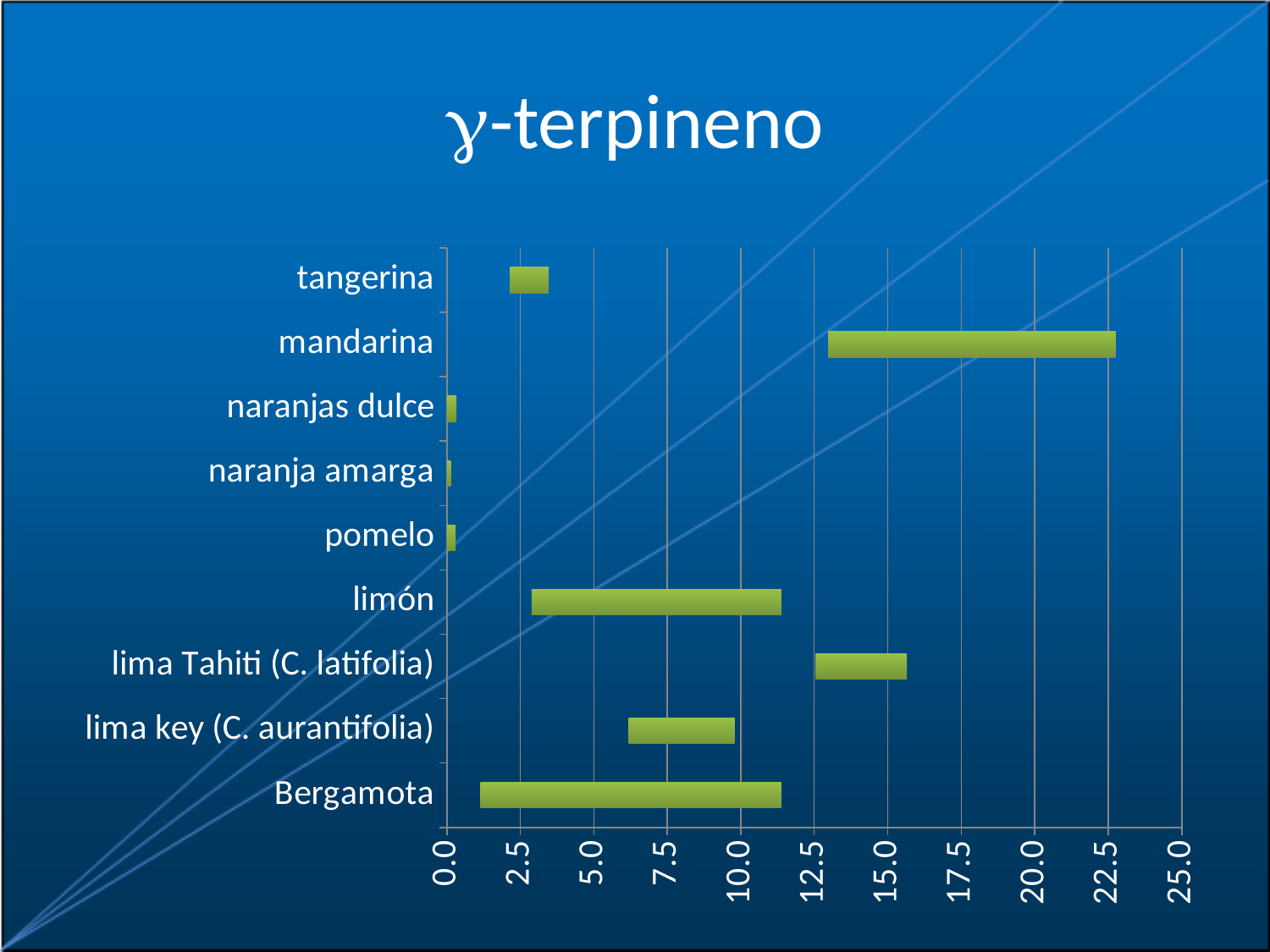
Which bar lies further to the right on the axis: lima Tahiti (C. latifolia) or lima key (C. aurantifolia)? lima Tahiti (C. latifolia) Which category's bar extends furthest to the right on the chart? mandarina What is the maximum value shown on the horizontal axis? 25.0 What kind of chart is shown on the slide? bar chart Is the upper end of the bar for mandarina greater or less than 20.0? greater Is the lower end of the bar for Bergamota greater or less than 2.5? less How many citrus categories are listed on the vertical axis of the chart? 9 Is the upper end of the bar for limón greater or less than 10.0? greater What is the title of the chart? γ-terpineno Which bar reaches higher values: mandarina or tangerina? mandarina